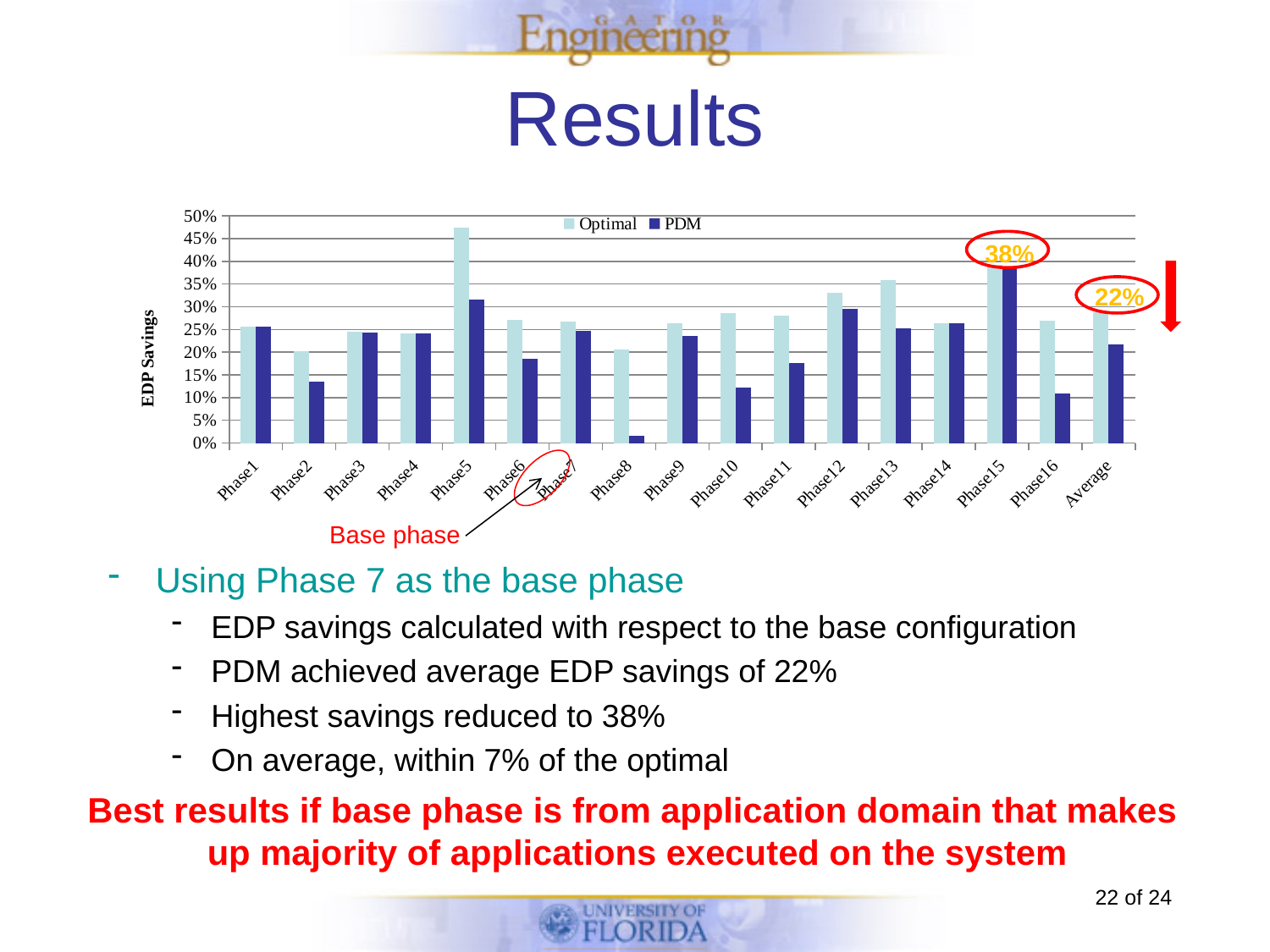
Which category has the highest Optimal value? Phase5 What is the PDM value for Average, as annotated on the chart? 22% Is the Optimal value for Phase5 greater or less than 45%? greater What is the label of the y axis? EDP Savings Which category has the lowest PDM value? Phase8 How many series does the legend list? 2 Is the PDM value for Phase8 greater or less than 5%? less For Phase5, which series has the larger value, Optimal or PDM? Optimal Is the PDM value for Phase11 greater or less than 20%? less How many categories are shown on the x axis? 17 Which phase has the highest PDM value? Phase15 What is the PDM value for Phase15, as annotated on the chart? 38%